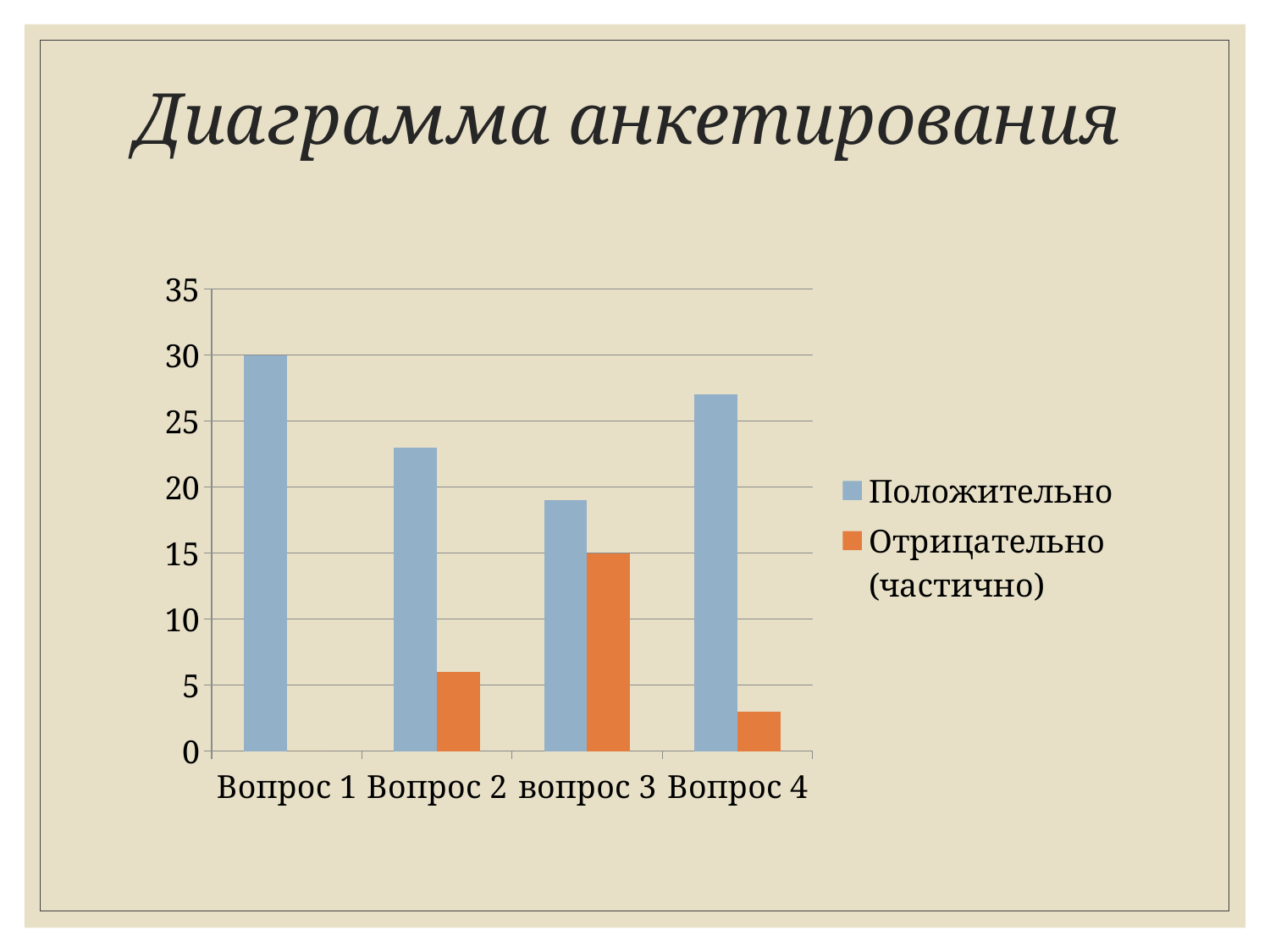
How many categories are shown on the x axis? 4 What is the value of Отрицательно (частично) for вопрос 3? 15 Which category has the lowest Положительно value? вопрос 3 Is the Положительно value for Вопрос 2 greater or less than 20? greater Which category has the highest Положительно value? Вопрос 1 What is the value of Положительно for Вопрос 1? 30 Which is larger for Вопрос 2: Положительно or Отрицательно (частично)? Положительно How many series does the legend list? 2 Which category has the highest Отрицательно (частично) value? вопрос 3 What kind of chart is shown on the slide? bar chart Is the Отрицательно (частично) value for Вопрос 4 greater or less than 5? less What is the title of the slide? Диаграмма анкетирования